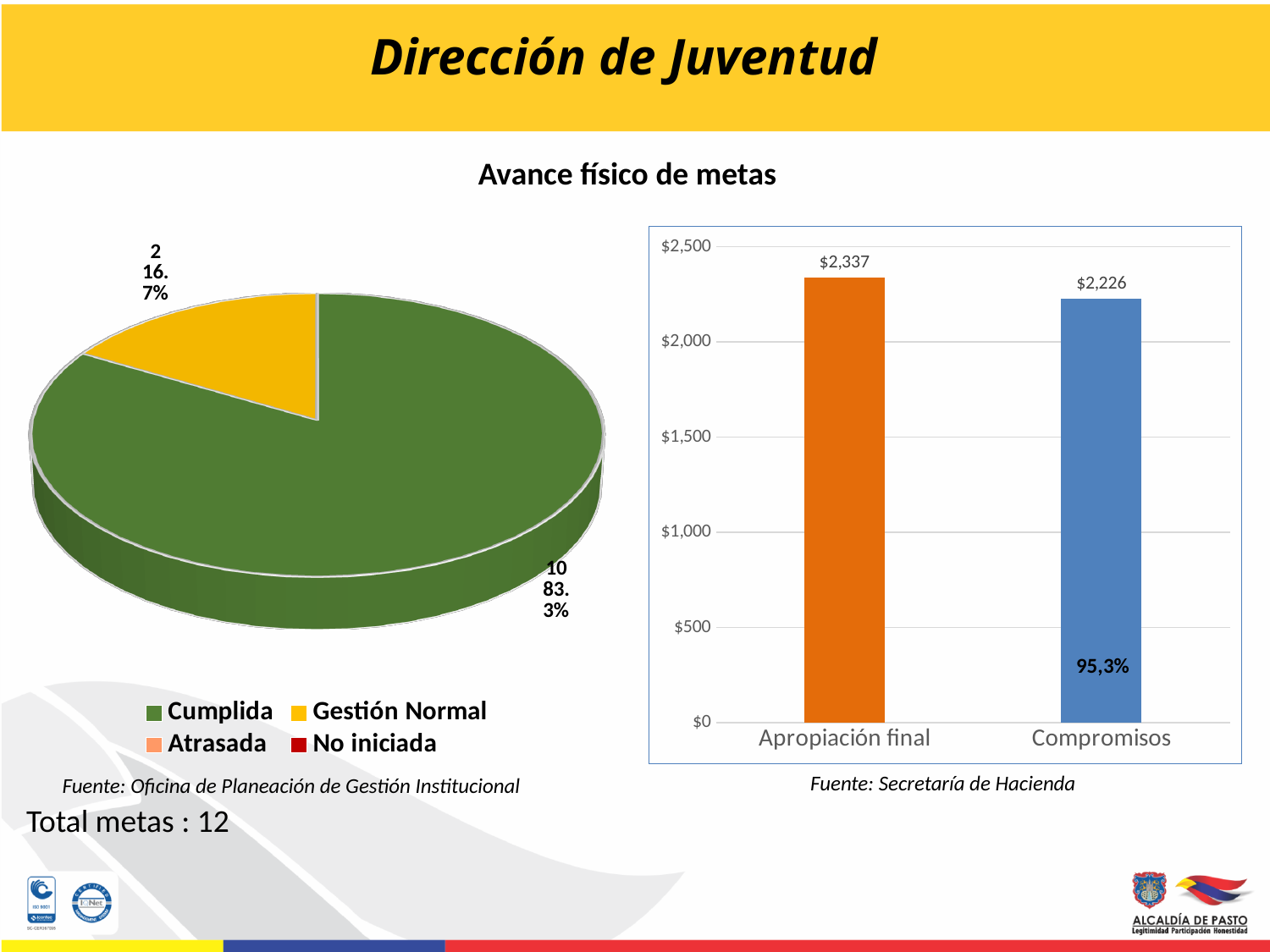
On the pie chart on the left, how many metas are labelled Cumplida? 10 On the bar chart on the right, how many bars are plotted? 2 On the pie chart on the left, what percentage share does the Cumplida slice have? 83.3% What kind of chart is the chart on the right of the slide? Bar chart On the bar chart on the right, what is the difference between Apropiación final and Compromisos? $111 On the bar chart on the right, which is larger, Apropiación final or Compromisos? Apropiación final On the pie chart on the left, how many categories does the legend list? 4 On the pie chart on the left, what percentage share does the Gestión Normal slice have? 16.7% On the pie chart on the left, what colour is the Cumplida slice? Green On the bar chart on the right, what is the value for Apropiación final? $2,337 On the bar chart on the right, what is the value for Compromisos? $2,226 On the pie chart on the left, which category has the largest slice? Cumplida